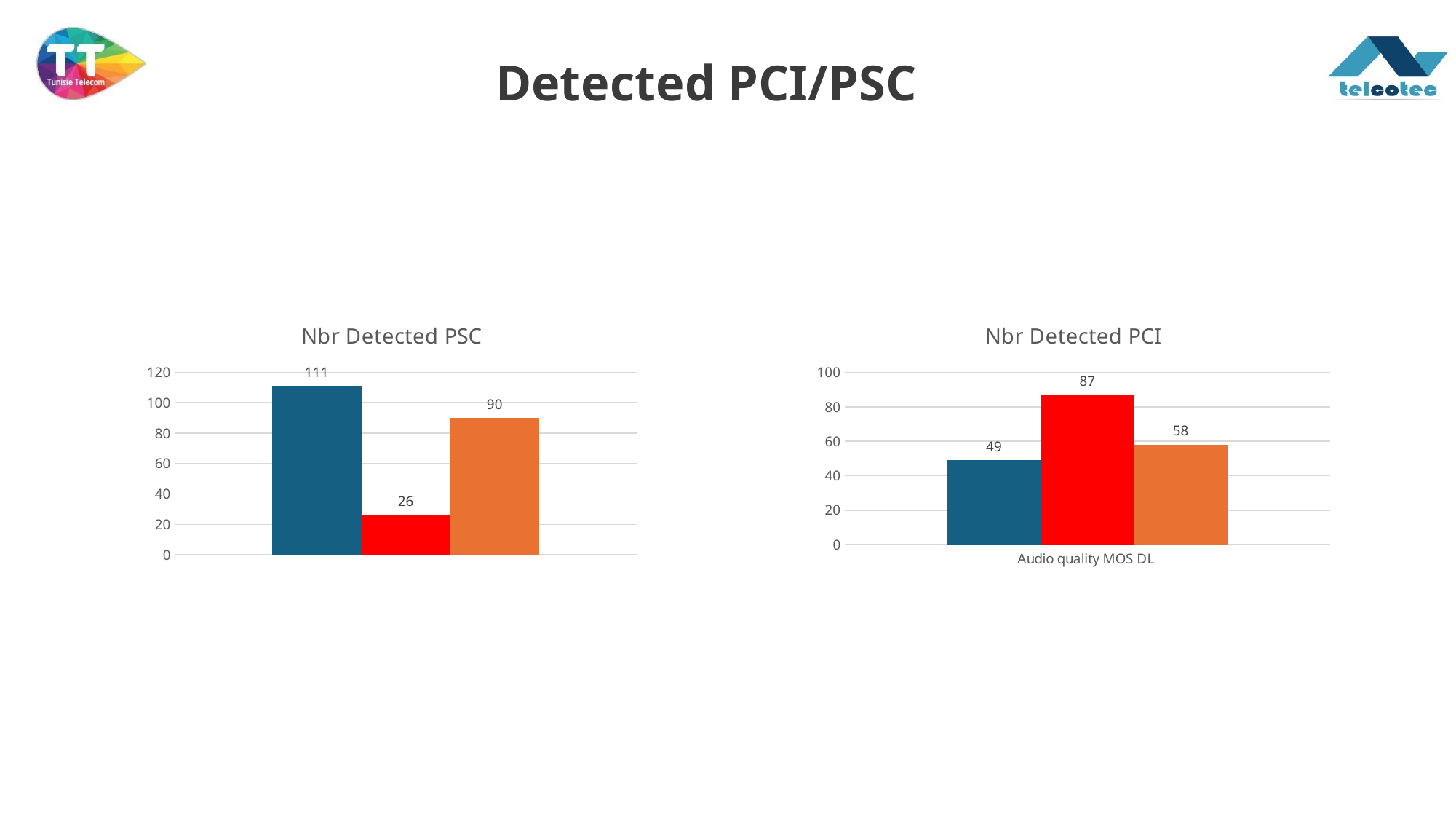
In the 'Nbr Detected PCI' chart, what is the value of the orange bar? 58 In the 'Nbr Detected PSC' chart, what is the difference between the dark blue bar and the orange bar? 21 In the 'Nbr Detected PCI' chart, what is the difference between the red bar and the dark blue bar? 38 In the 'Nbr Detected PSC' chart, what is the value of the orange bar? 90 In the 'Nbr Detected PCI' chart, what is the value of the red bar? 87 What type of chart is the 'Nbr Detected PSC' chart? bar chart In the 'Nbr Detected PCI' chart, which is larger, the dark blue bar or the orange bar? the orange bar In the 'Nbr Detected PSC' chart, what is the value of the red bar? 26 In the 'Nbr Detected PSC' chart, which bar is the lowest? the red bar How many bars are plotted in the 'Nbr Detected PCI' chart? 3 In the 'Nbr Detected PSC' chart, what is the value of the dark blue bar? 111 In the 'Nbr Detected PCI' chart, which bar is the highest? the red bar